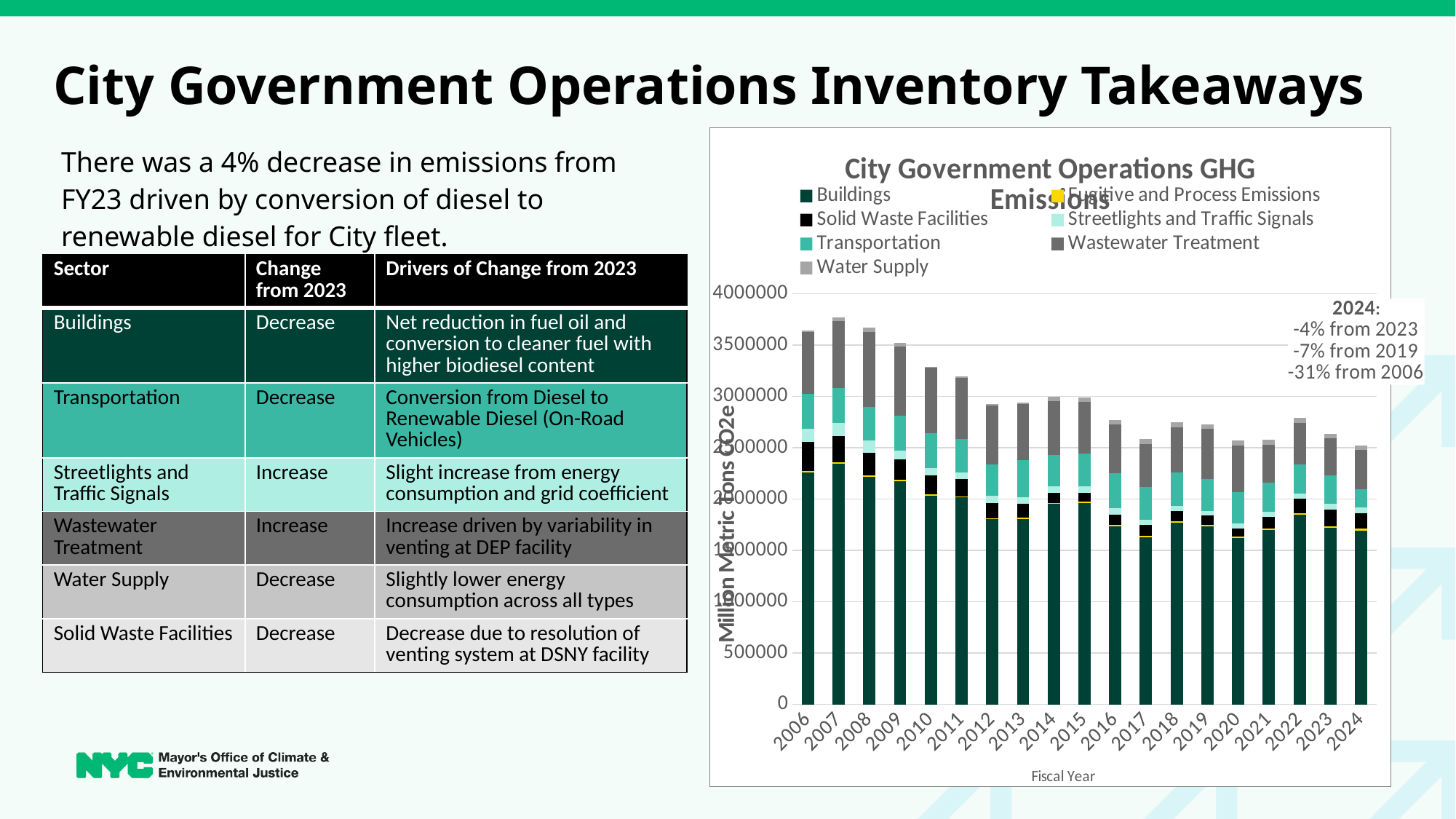
What is the title of the chart? City Government Operations GHG Emissions Is the total emissions bar for 2006 greater or less than 3500000? greater According to the annotation on the chart, by what percentage did 2024 emissions change from 2006? -31% Which fiscal year has the highest total emissions bar in the chart? 2007 Do total emissions generally rise or fall from 2006 to 2024 in the chart? Fall What kind of chart is shown on the slide? Stacked bar chart Is the total emissions bar for 2012 greater or less than 3000000? less Is the Buildings segment for 2024 greater or less than 2000000? less How many fiscal years are plotted on the x axis of the chart? 19 Which fiscal year has the lowest total emissions bar in the chart? 2024 How many series does the chart legend list? 7